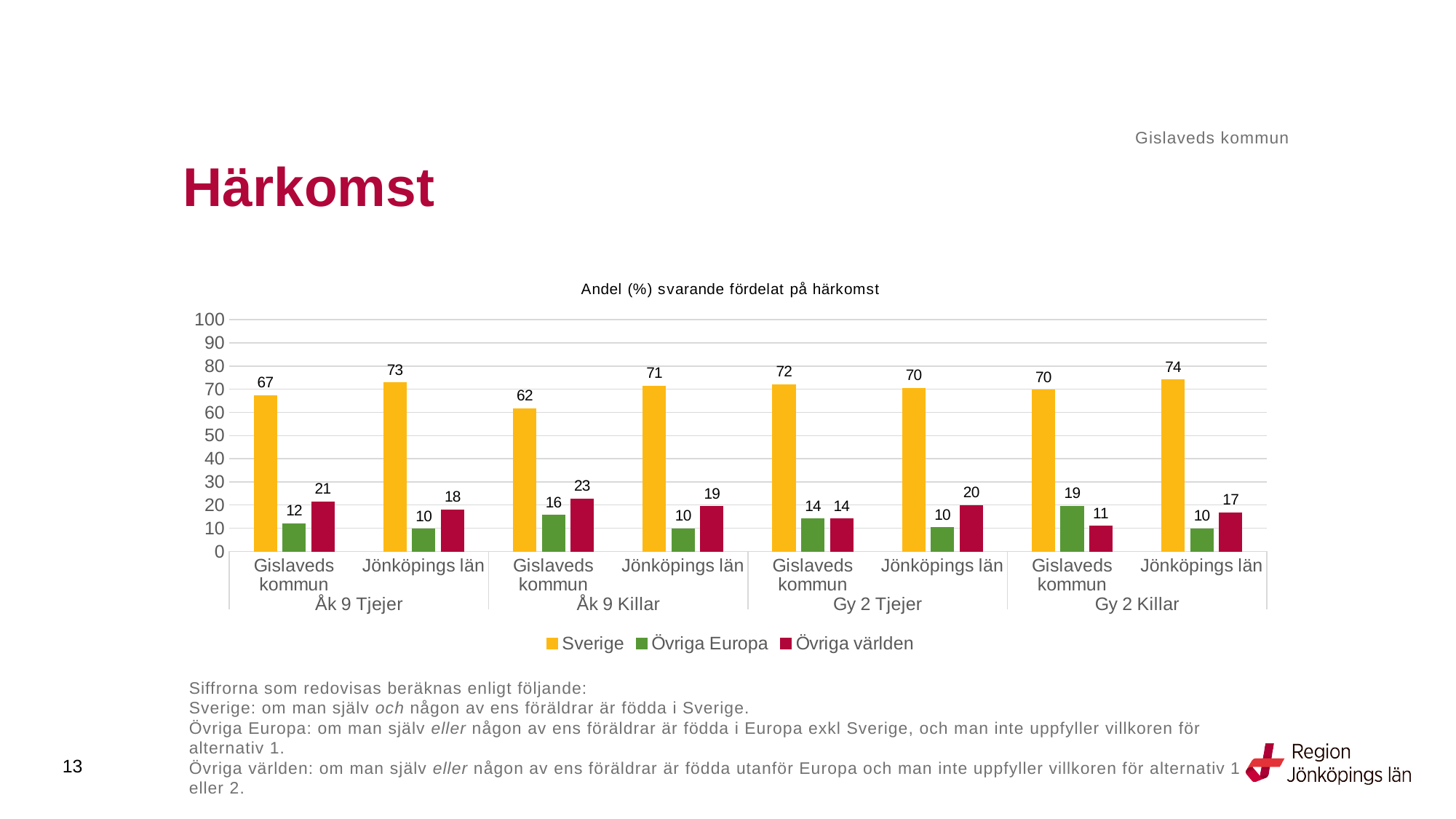
Is the Sverige value for Gislaveds kommun in the Gy 2 Tjejer group greater or less than 60? greater Which category has the highest Sverige value? Jönköpings län (Gy 2 Killar) What is the title of the chart? Andel (%) svarande fördelat på härkomst In the Gy 2 Killar group, which is larger for Gislaveds kommun: Övriga Europa or Övriga världen? Övriga Europa What colour represents the Sverige series? Yellow What is the value for Sverige for Gislaveds kommun in the Åk 9 Tjejer group? 67 What is the difference between the Sverige values for Jönköpings län and Gislaveds kommun in the Åk 9 Killar group? 9 What is the value for Övriga Europa for Jönköpings län in the Gy 2 Killar group? 10 How many series does the legend list? 3 What is the value for Övriga världen for Gislaveds kommun in the Åk 9 Killar group? 23 What kind of chart is shown on the slide? Bar chart Which category has the lowest Sverige value? Gislaveds kommun (Åk 9 Killar)